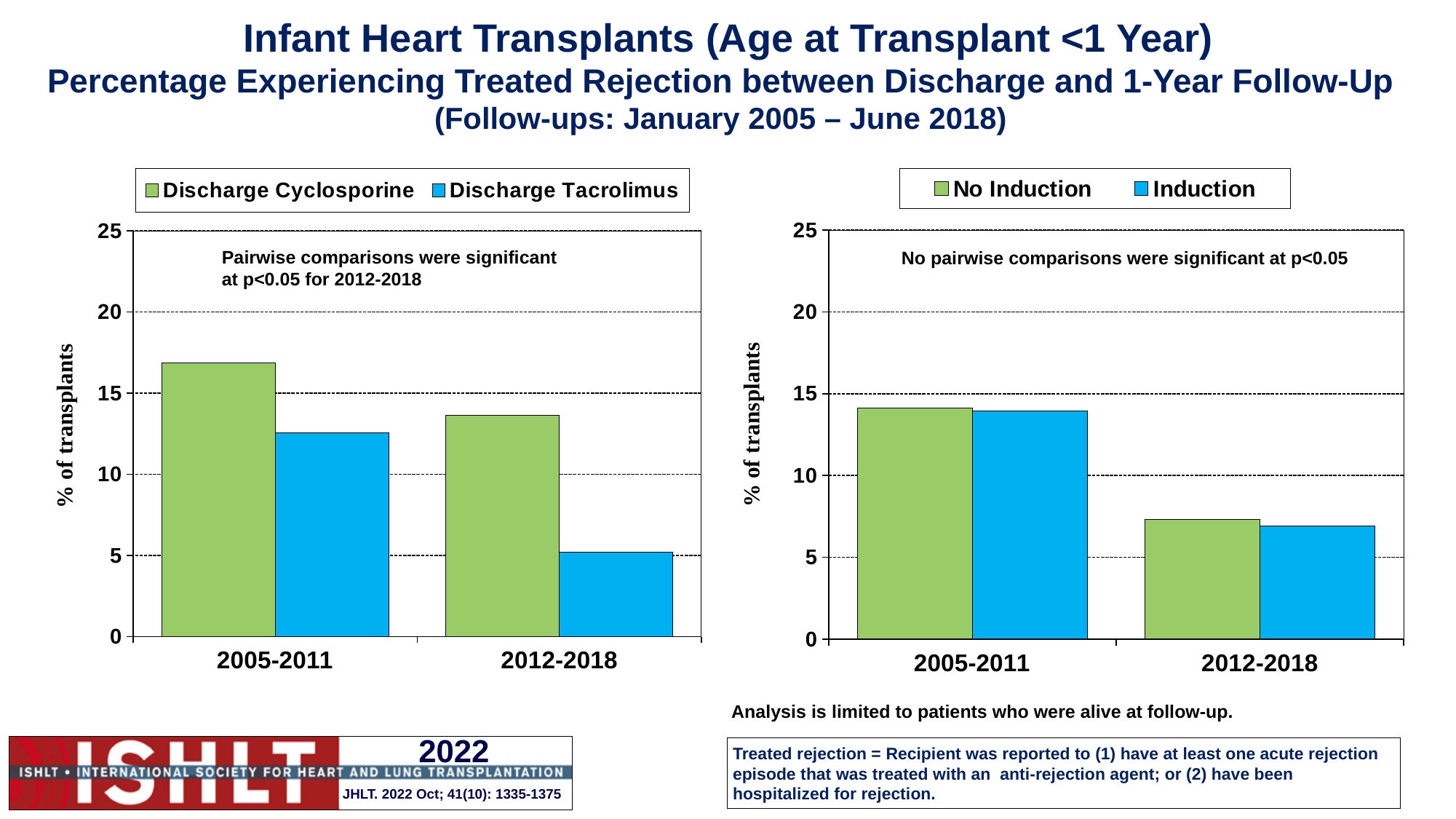
In the right chart, is the value for No Induction in 2012-2018 greater or less than 10? less In the right chart, is the value for Induction in 2005-2011 greater or less than 10? greater In the right chart, do the Induction values rise or fall from 2005-2011 to 2012-2018? fall In the left chart, is the value for Discharge Tacrolimus in 2012-2018 greater or less than 10? less In the left chart, which bar is the highest? Discharge Cyclosporine, 2005-2011 What kind of chart is the left chart (Discharge Cyclosporine vs Discharge Tacrolimus)? bar chart In the left chart, which bar is the lowest? Discharge Tacrolimus, 2012-2018 How many time-period categories are shown on the x axis of the left chart? 2 How many series does the legend of the right chart list? 2 In the left chart, which is larger in 2012-2018: Discharge Cyclosporine or Discharge Tacrolimus? Discharge Cyclosporine What are the two legend entries of the right chart? No Induction and Induction